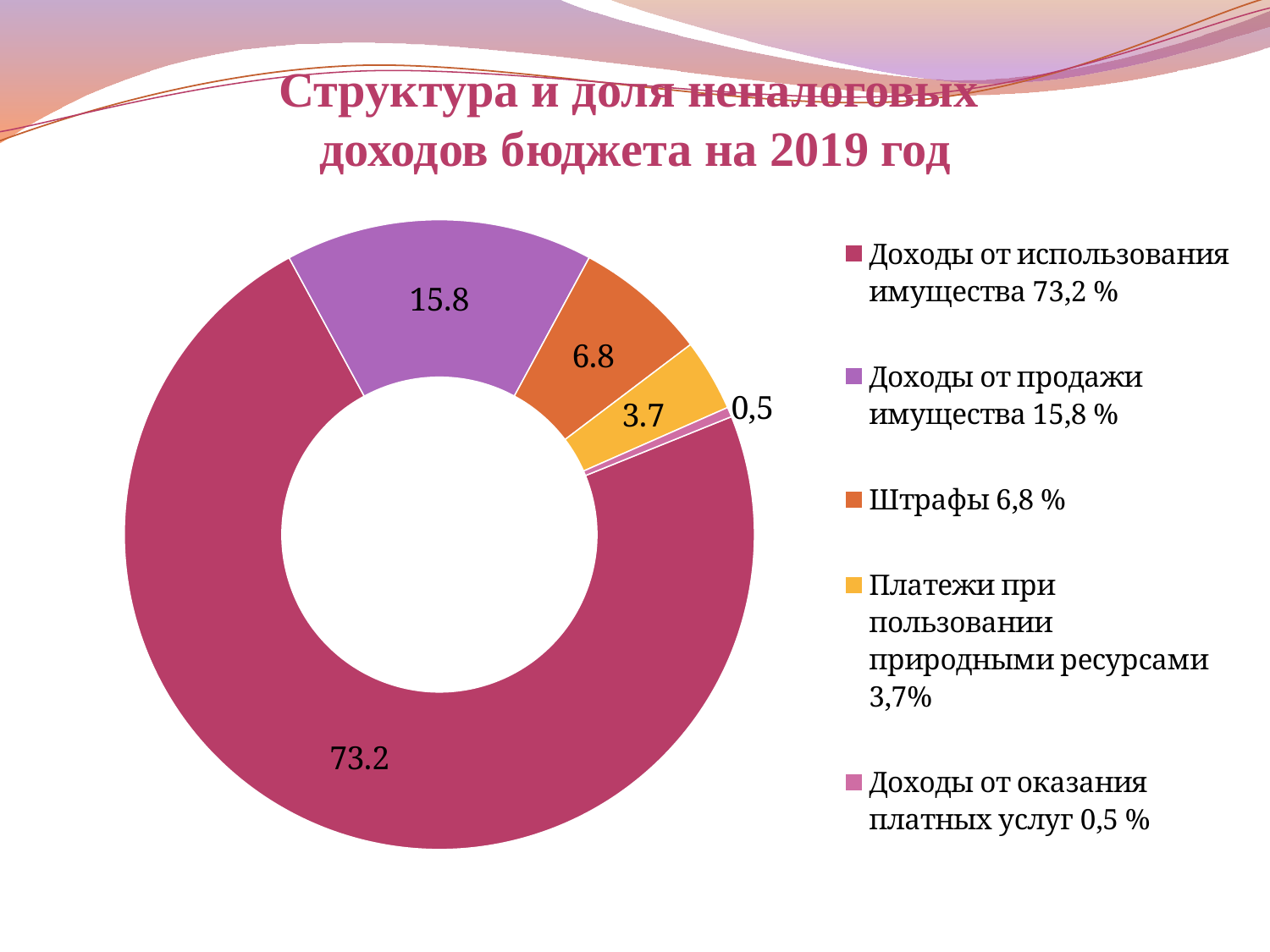
What value is shown for the slice "Доходы от продажи имущества"? 15.8 What value is shown for the slice "Платежи при пользовании природными ресурсами"? 3.7 What kind of chart is shown on the slide? doughnut chart Which is larger, the slice for "Штрафы" or the slice for "Платежи при пользовании природными ресурсами"? Штрафы What value is shown for the slice "Доходы от использования имущества"? 73.2 What value is shown for the slice "Штрафы"? 6.8 What is the difference between the values for "Доходы от продажи имущества" and "Штрафы"? 9.0 Which category has the largest slice? Доходы от использования имущества What is the title of the chart on the slide? Структура и доля неналоговых доходов бюджета на 2019 год How many slices does the chart have? 5 Which category has the smallest slice? Доходы от оказания платных услуг What is the difference between the values for "Доходы от использования имущества" and "Доходы от продажи имущества"? 57.4